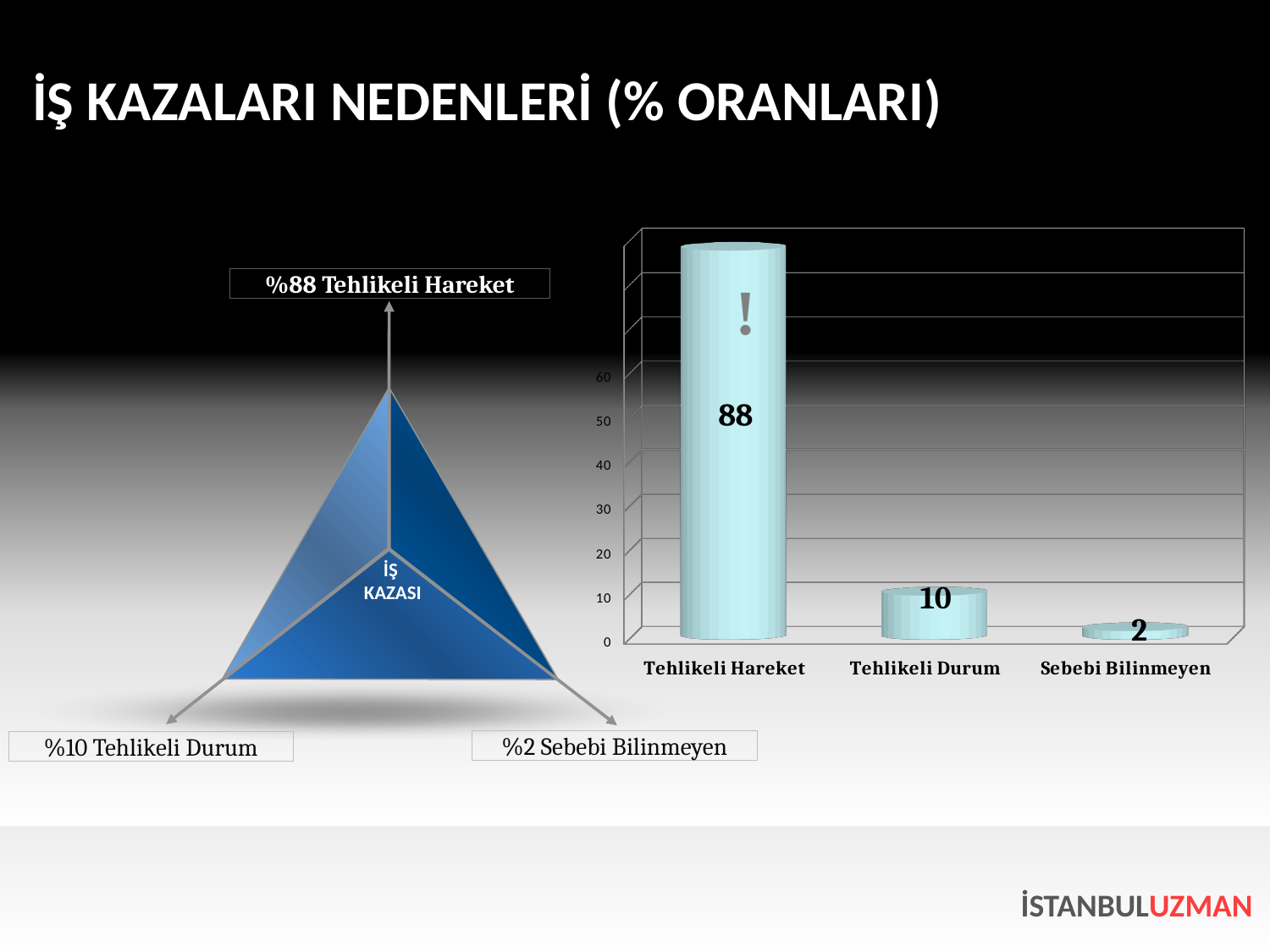
What is the value for Tehlikeli Durum in the bar chart? 10 What kind of chart is shown on the right side of the slide? bar chart What is the difference between the values for Tehlikeli Hareket and Tehlikeli Durum in the bar chart? 78 What is the value for Tehlikeli Hareket in the bar chart? 88 How many categories are shown in the bar chart? 3 Which category has the highest value in the bar chart? Tehlikeli Hareket Is the value for Tehlikeli Hareket in the bar chart greater or less than 60? greater What is the title of the slide containing the bar chart? İŞ KAZALARI NEDENLERİ (% ORANLARI) What is the value for Sebebi Bilinmeyen in the bar chart? 2 In the bar chart, which is larger: the value for Tehlikeli Durum or the value for Sebebi Bilinmeyen? Tehlikeli Durum Which category has the lowest value in the bar chart? Sebebi Bilinmeyen What is the difference between the values for Tehlikeli Durum and Sebebi Bilinmeyen in the bar chart? 8